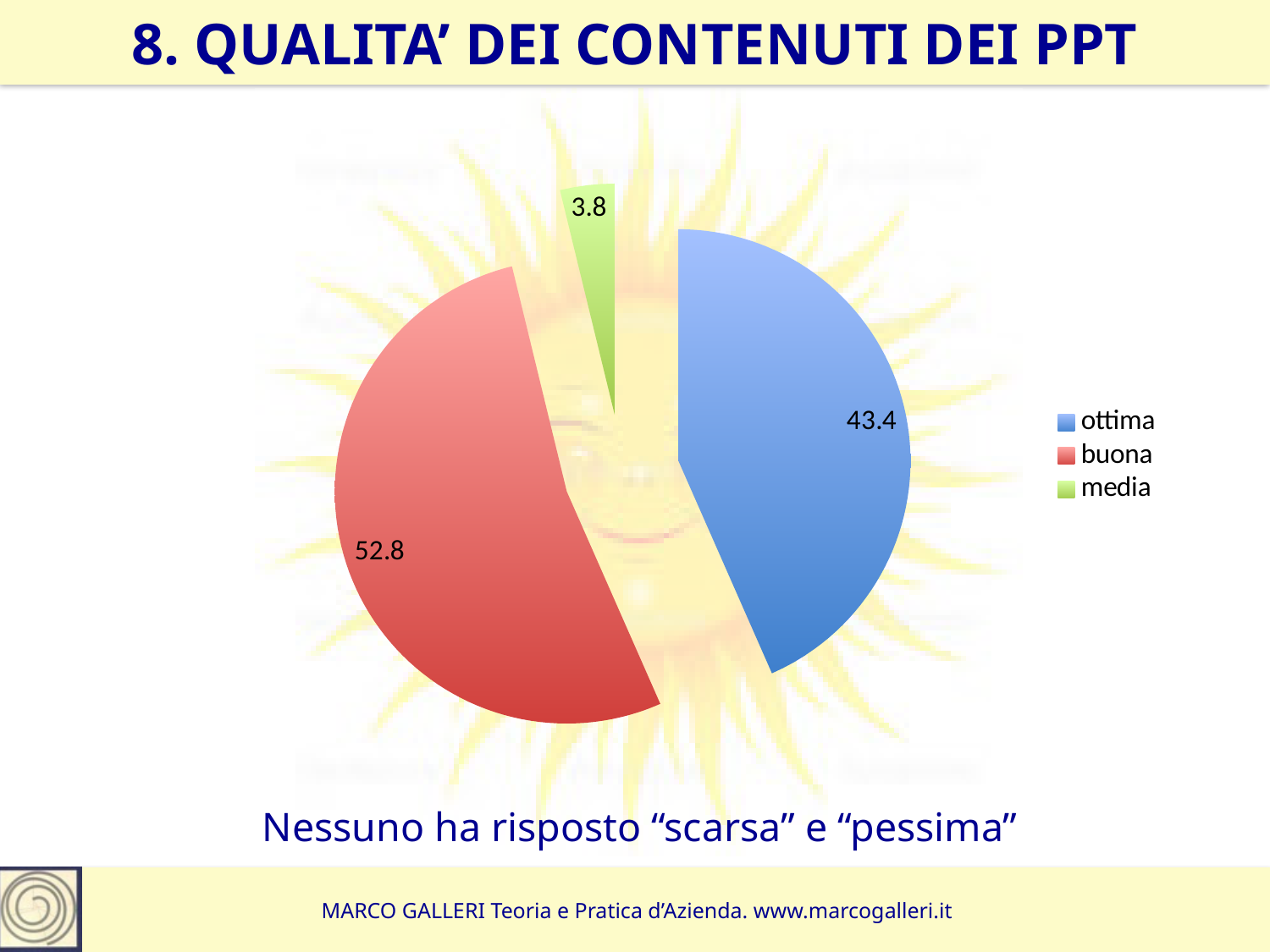
What is the difference between the values for "ottima" and "media"? 39.6 What colour is the "media" slice in the pie chart? green What is the difference between the values for "buona" and "ottima"? 9.4 How many entries does the legend of the chart list? 3 What value is shown for the "ottima" slice of the pie chart? 43.4 How many slices does the pie chart have? 3 Which is larger, the value for "ottima" or the value for "buona"? buona Which category has the largest slice in the pie chart? buona What kind of chart is shown on the slide? pie chart Which category has the smallest slice in the pie chart? media What value is shown for the "media" slice of the pie chart? 3.8 What value is shown for the "buona" slice of the pie chart? 52.8